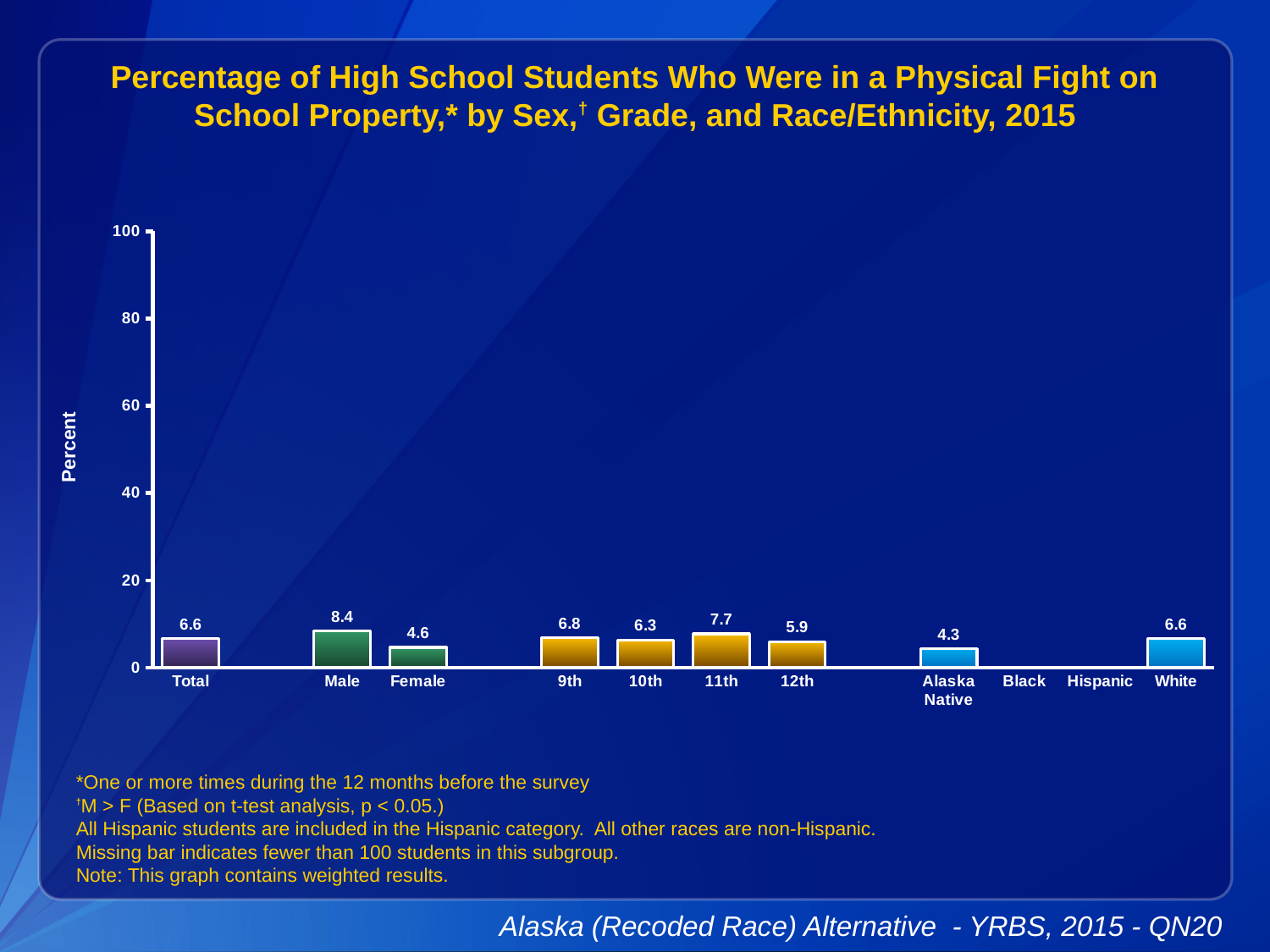
What is the value for Alaska Native? 4.3 What is the value for 11th grade? 7.7 Which is larger, the value for 9th grade or 10th grade? 9th Which category has the highest value? Male How many categories are labelled on the x axis? 11 Is the value for Total greater or less than 20? less What is the label on the y axis? Percent Which category with a bar has the lowest value? Alaska Native What is the value for Female? 4.6 What is the difference between the Male and Female values? 3.8 What kind of chart is shown? bar chart What is the value for Male? 8.4